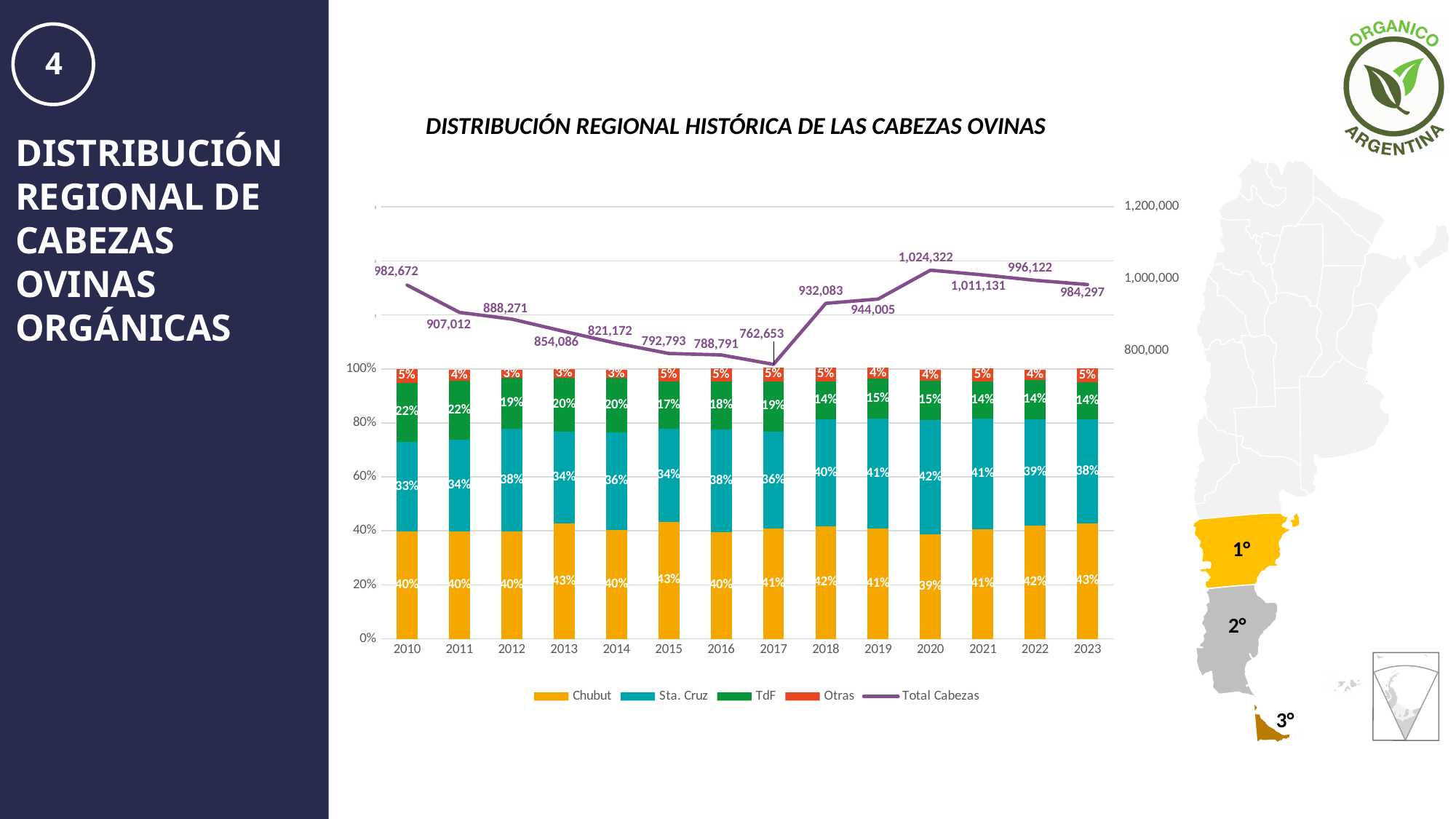
Which is larger, the Sta. Cruz share in 2010 or the Sta. Cruz share in 2020? 2020 How many series does the legend list? 5 In which year is Total Cabezas highest? 2020 Is the Total Cabezas value for 2015 greater or less than 800,000? less What is the value of Total Cabezas for 2020? 1,024,322 What percentage share does Chubut have in 2023? 43% What percentage share does TdF have in 2010? 22% What is the difference in Total Cabezas between 2020 and 2017? 261,669 What is the value of Total Cabezas for 2017? 762,653 How many years are shown on the x axis? 14 Does the Total Cabezas line rise or fall from 2010 to 2017? fall In which year is Total Cabezas lowest? 2017